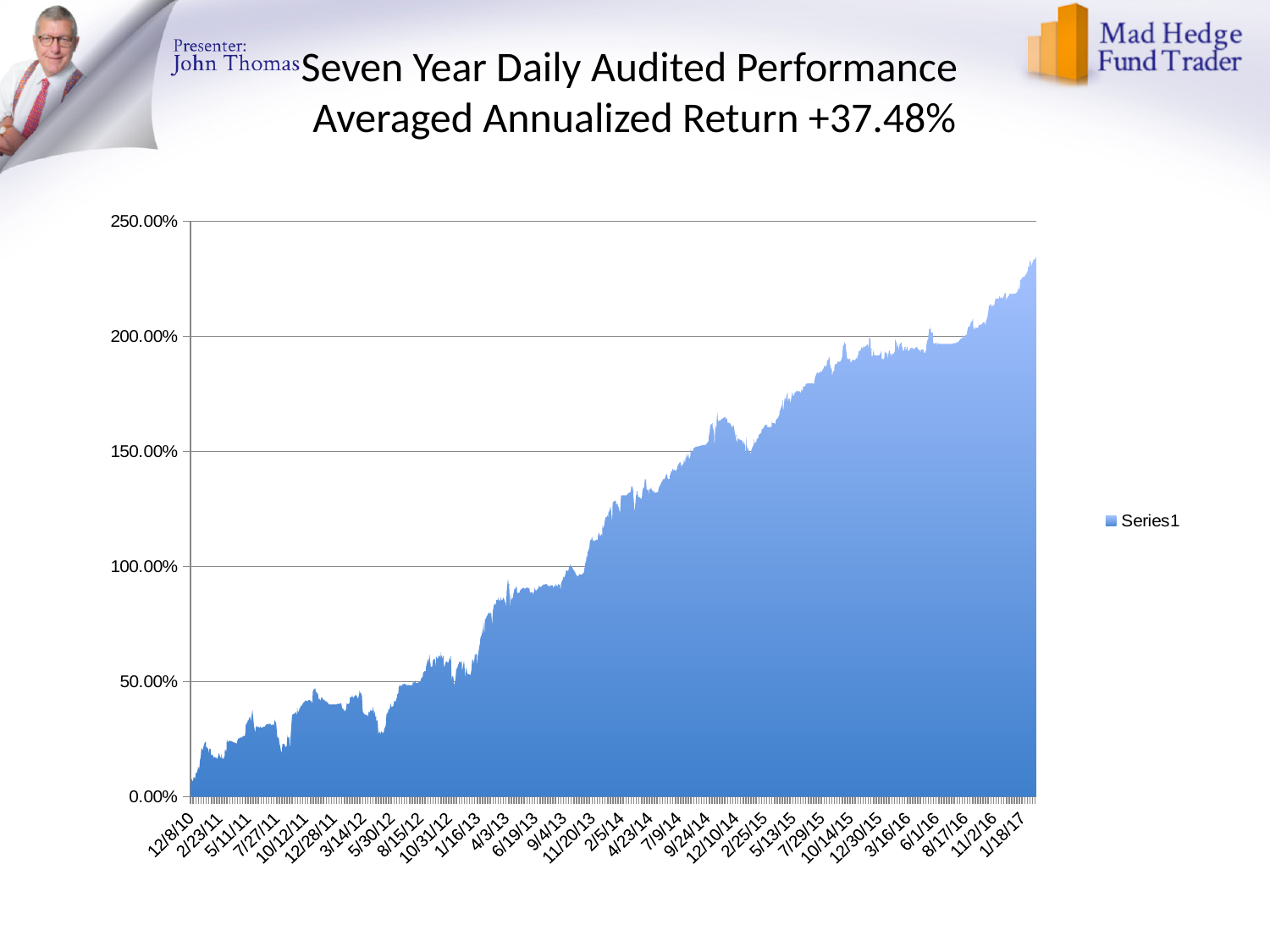
Is the value at 12/8/10 greater or less than 50%? less Is the value at 3/14/12 greater or less than 50%? less Is the value at 2/5/14 greater or less than 100%? greater Do the values generally rise or fall from left to right along the x axis? Rise Which is larger, the value at 9/24/14 or the value at 5/11/11? 9/24/14 What is the highest value shown on the y axis? 250.00% What is the name of the series shown in the legend? Series1 Which is larger, the value at 1/18/17 or the value at 12/8/10? 1/18/17 What kind of chart is shown on the slide? Area chart How many series does the legend list? 1